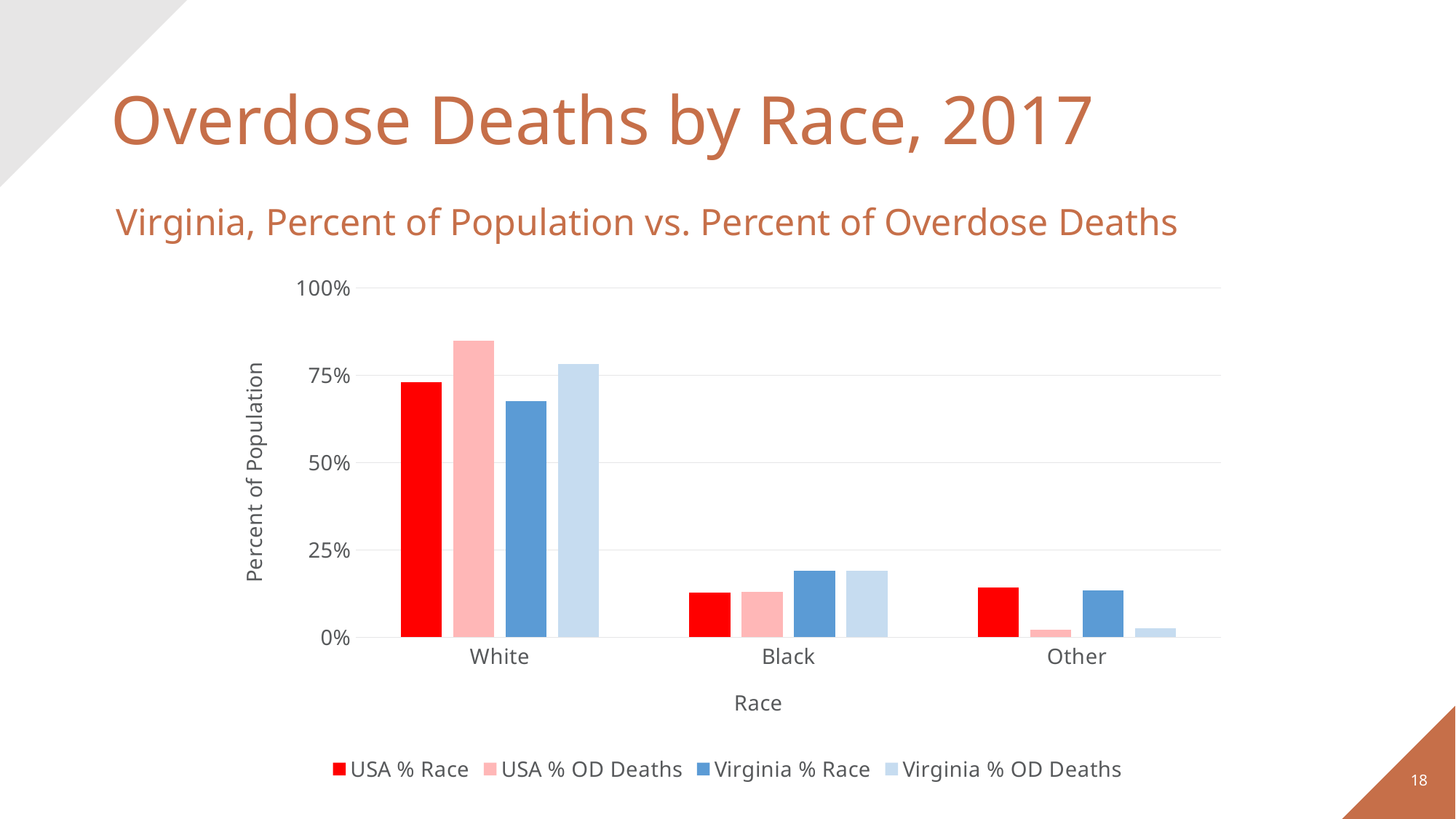
For Black, which is larger: USA % Race or Virginia % Race? Virginia % Race Is the value for Virginia % OD Deaths for Black greater or less than 25%? less For White, which is larger: USA % Race or USA % OD Deaths? USA % OD Deaths How many series does the legend list? 4 For Other, which is larger: USA % Race or USA % OD Deaths? USA % Race How many race categories are shown on the x axis? 3 What kind of chart is shown on the slide? bar chart Is the value for Virginia % Race for White greater or less than 75%? less What is the title of the y axis? Percent of Population Which race has the lowest USA % OD Deaths value? Other Which race has the highest USA % OD Deaths value? White Is the value for USA % OD Deaths for White greater or less than 75%? greater